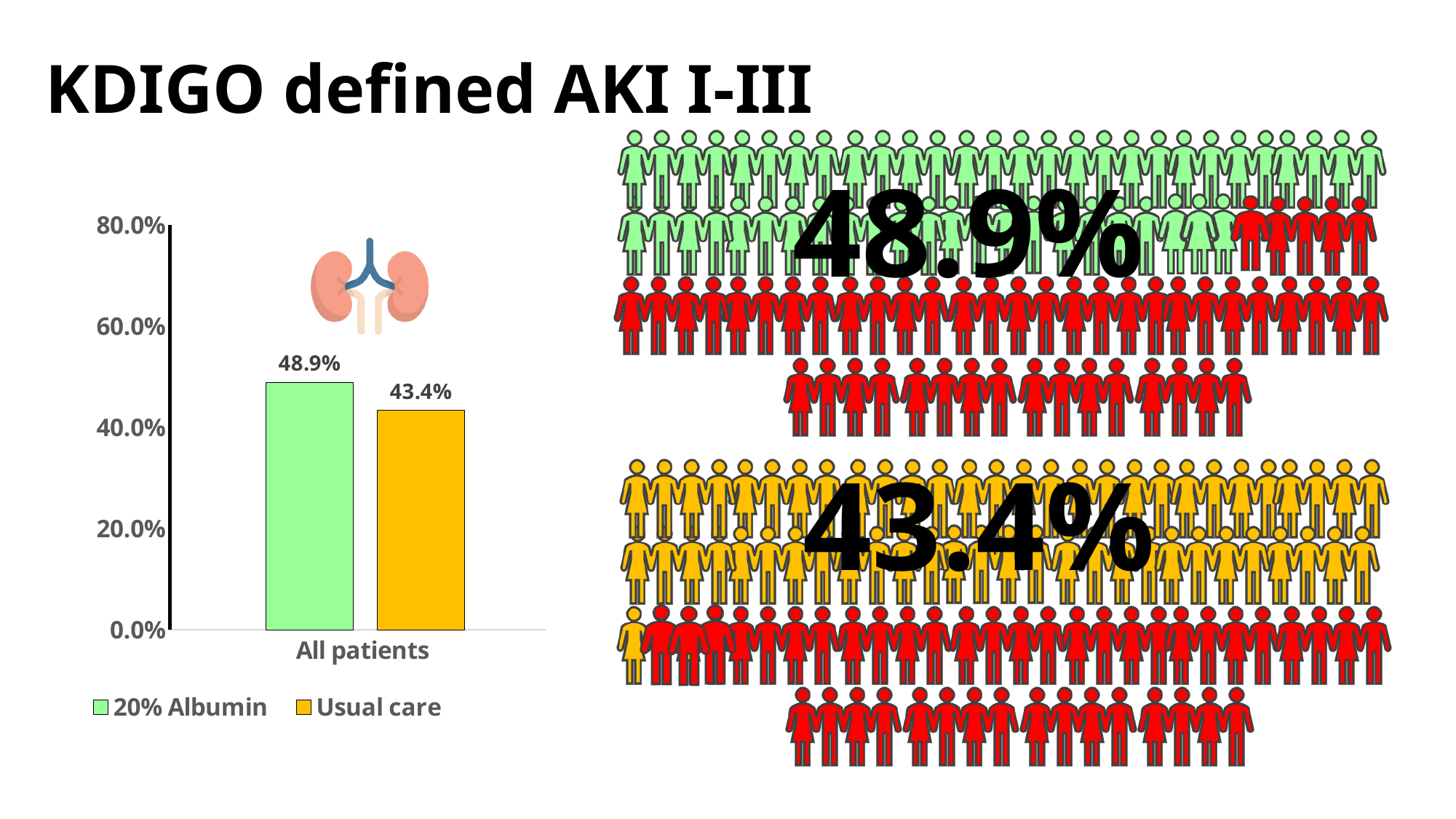
Is the value for 20% Albumin greater or less than 60.0%? less What colour is the Usual care bar? Orange How many series does the legend list? 2 Is the value for Usual care greater or less than 40.0%? greater Which series has the lowest value on the chart? Usual care What is the value for Usual care in the All patients category? 43.4% Which series has the higher value for All patients, 20% Albumin or Usual care? 20% Albumin What is the label of the category on the x axis? All patients How many categories are shown on the x axis? 1 What is the difference between the 20% Albumin and Usual care values? 5.5% What is the value for 20% Albumin in the All patients category? 48.9% What kind of chart is shown on the slide? Bar chart